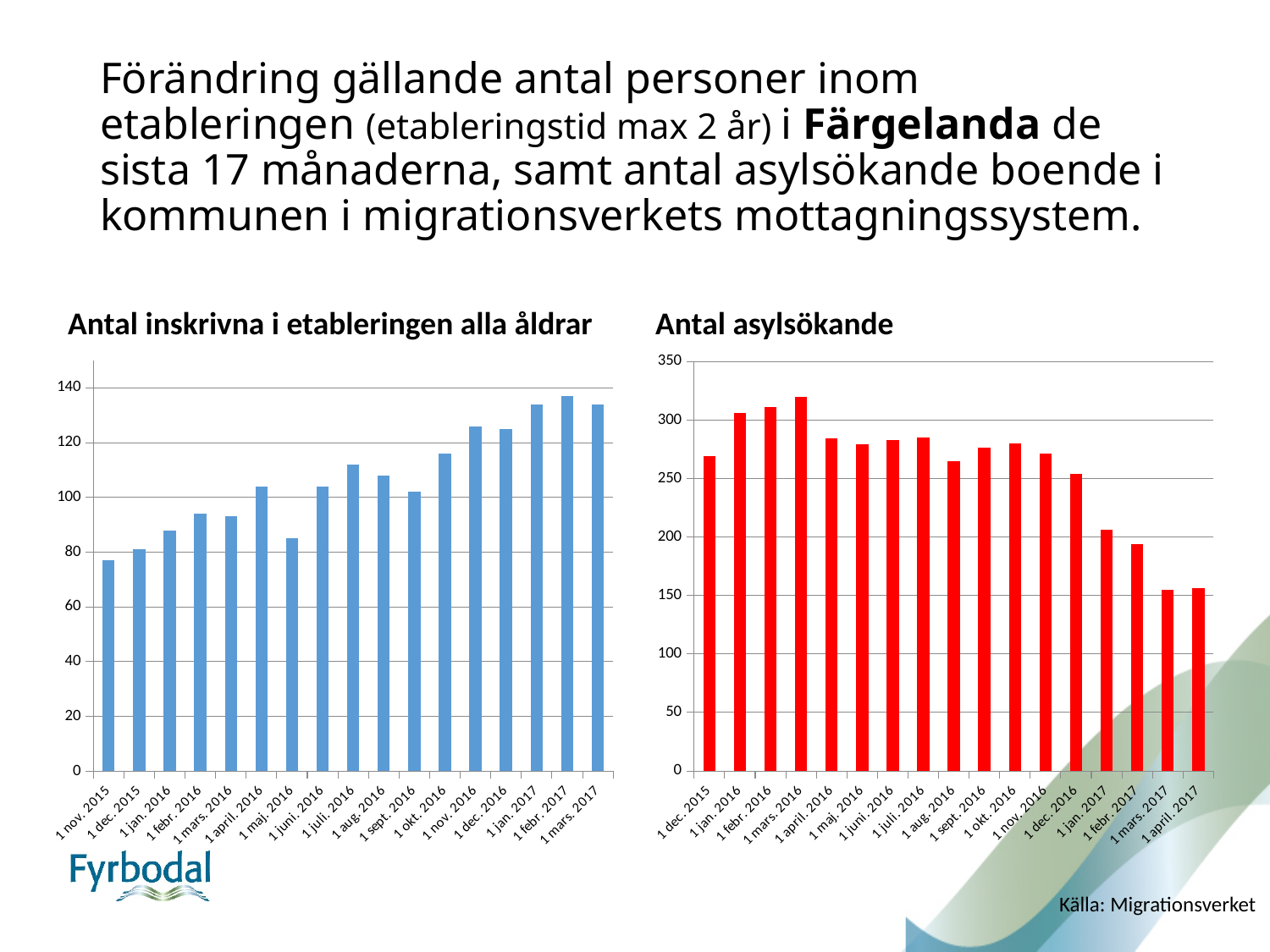
In the 'Antal asylsökande' chart, is the value for 1 mars 2016 greater or less than 300? greater In the 'Antal inskrivna i etableringen alla åldrar' chart, which date has the lowest value? 1 nov. 2015 In the 'Antal asylsökande' chart, do the values generally rise or fall from left to right? fall In the 'Antal asylsökande' chart, which date has the highest value? 1 mars 2016 In the 'Antal inskrivna i etableringen alla åldrar' chart, is the value for 1 nov. 2015 greater or less than 80? less What colour are the bars in the 'Antal asylsökande' chart? red In the 'Antal asylsökande' chart, is the value for 1 mars 2017 greater or less than 200? less How many bars are shown in the 'Antal asylsökande' chart? 17 In the 'Antal inskrivna i etableringen alla åldrar' chart, which is larger: the value for 1 maj 2016 or 1 nov. 2016? 1 nov. 2016 What kind of chart is the 'Antal inskrivna i etableringen alla åldrar' chart? bar chart In the 'Antal asylsökande' chart, which is larger: the value for 1 dec. 2015 or 1 jan. 2016? 1 jan. 2016